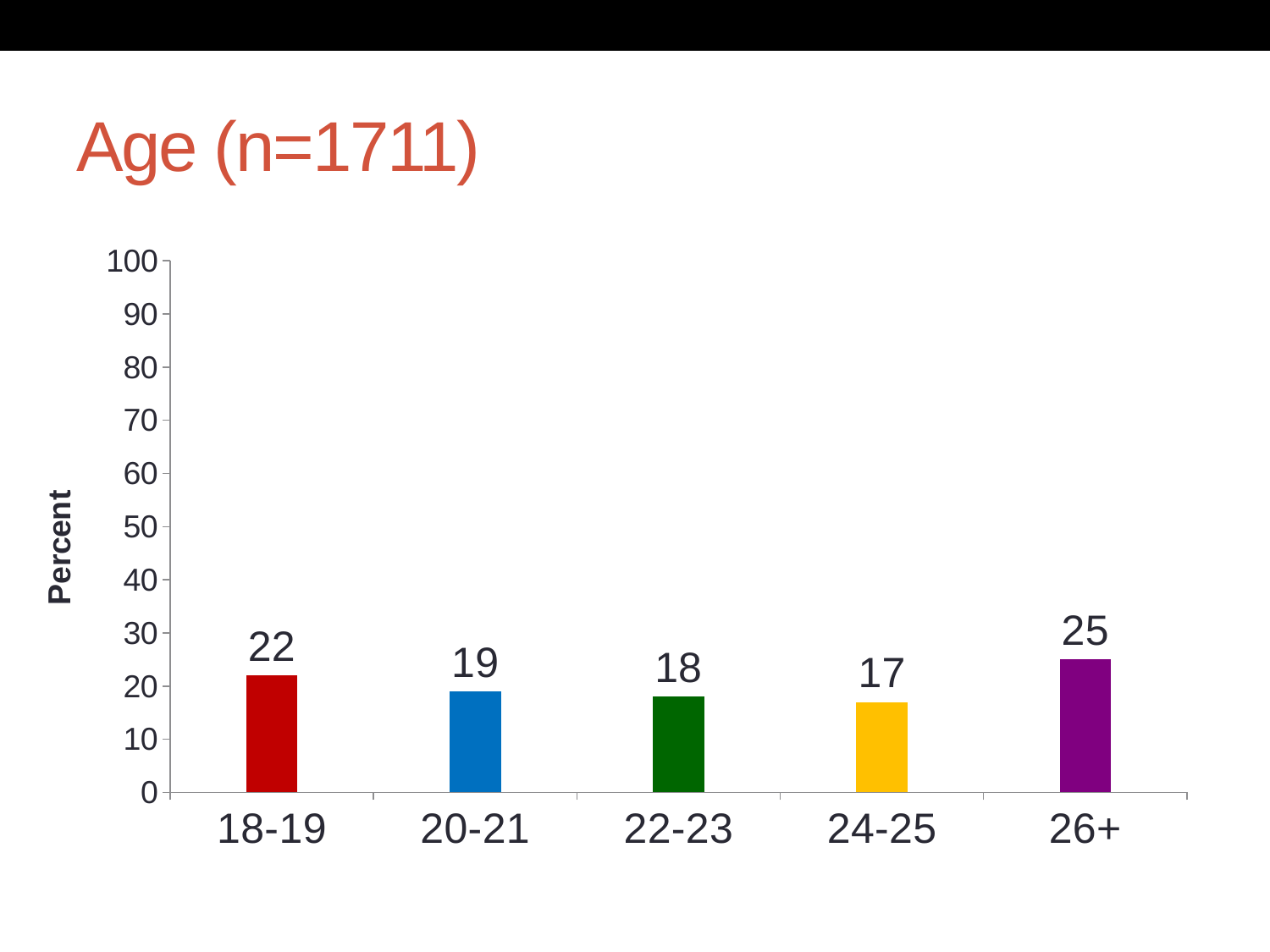
What is the label on the vertical axis of the chart? Percent Is the value for 26+ greater or less than 30? less What is the value for the 26+ age group? 25 What is the difference between the values for 18-19 and 20-21? 3 Which is larger, the value for 18-19 or the value for 22-23? 18-19 Which age group has the highest value? 26+ How many age groups are shown on the chart? 5 Which age group has the lowest value? 24-25 What is the value for the 24-25 age group? 17 What kind of chart is shown on the slide? bar chart What is the value for the 18-19 age group? 22 What is the difference between the values for 26+ and 24-25? 8